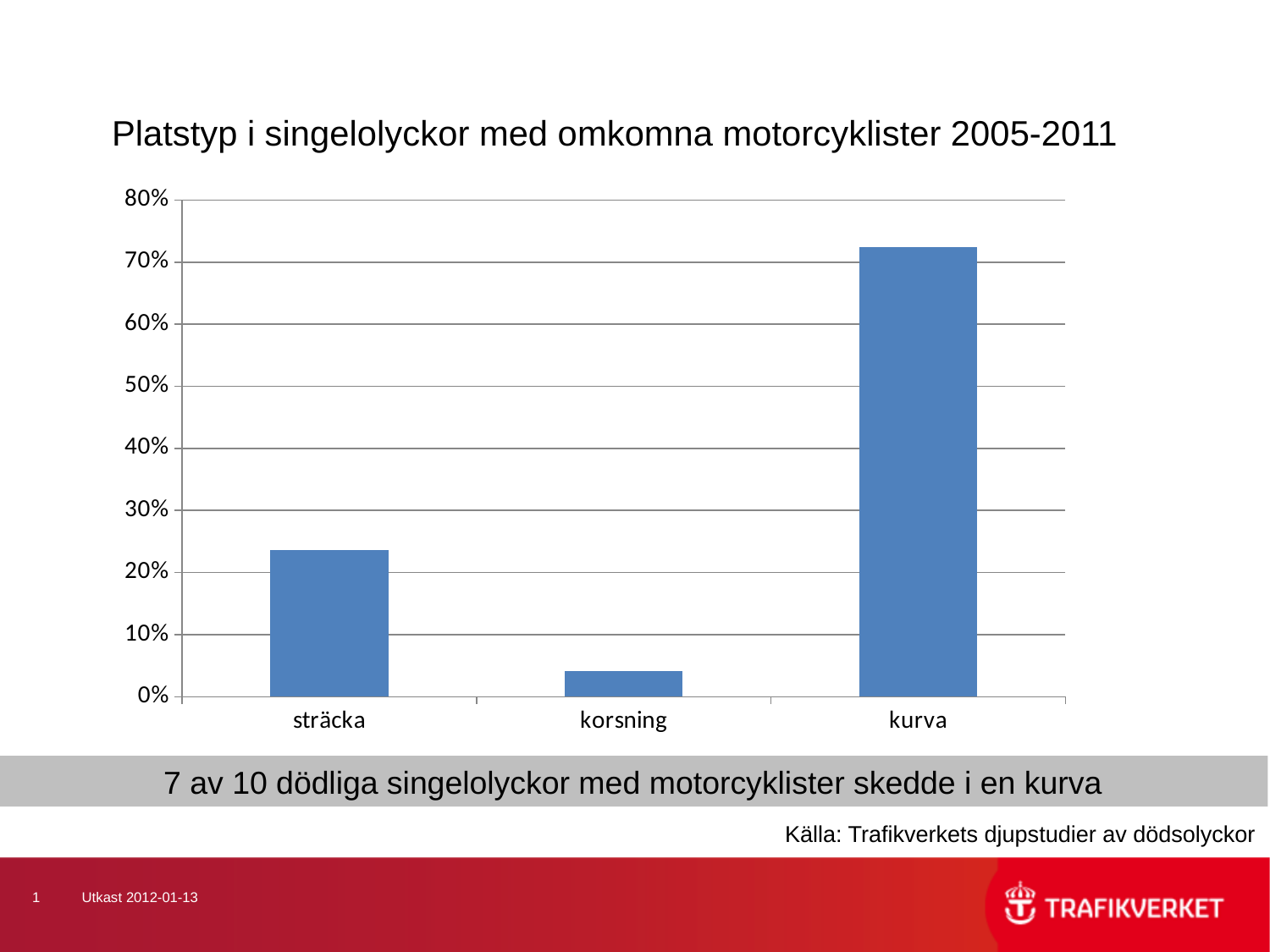
How many categories are shown on the x axis of the chart? 3 Which is larger, the value for sträcka or the value for korsning? sträcka Which category has the highest value? kurva Is the value for kurva greater or less than 70%? greater What is the highest value shown on the y axis? 80% Is the value for korsning greater or less than 10%? less Which is larger, the value for kurva or the value for sträcka? kurva Which category has the lowest value? korsning Is the value for sträcka greater or less than 20%? greater What kind of chart is shown on the slide? bar chart What is the title of the chart? Platstyp i singelolyckor med omkomna motorcyklister 2005-2011